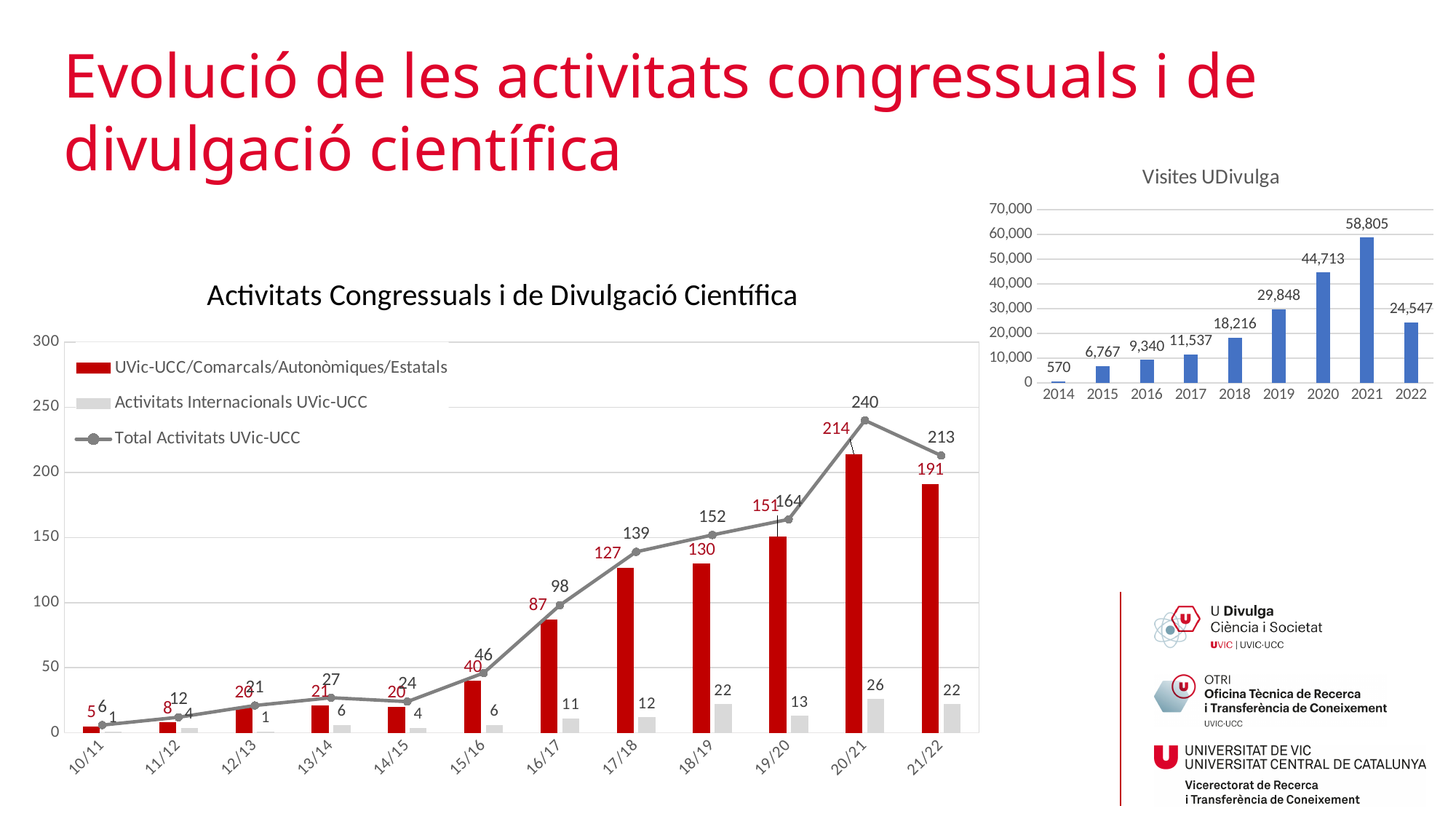
In the Visites UDivulga chart, what is the difference between the visits in 2021 and in 2022? 34,258 In the Activitats Congressuals i de Divulgació Científica chart, how many series does the legend list? 3 What kind of chart is the Visites UDivulga chart? Bar chart In the Activitats Congressuals i de Divulgació Científica chart, which year has the larger value for UVic-UCC/Comarcals/Autonòmiques/Estatals, 20/21 or 21/22? 20/21 In the Visites UDivulga chart, which year has the lowest number of visits? 2014 In the Activitats Congressuals i de Divulgació Científica chart, what is the value of Total Activitats UVic-UCC for 20/21? 240 In the Activitats Congressuals i de Divulgació Científica chart, what is the value of UVic-UCC/Comarcals/Autonòmiques/Estatals for 17/18? 127 In the Visites UDivulga chart, which year has the highest number of visits? 2021 In the Visites UDivulga chart, do the values rise or fall from 2014 to 2021? Rise In the Visites UDivulga chart, how many years are plotted? 9 In the Visites UDivulga chart, how many visits are shown for 2021? 58,805 In the Activitats Congressuals i de Divulgació Científica chart, how many academic years are shown on the x axis? 12